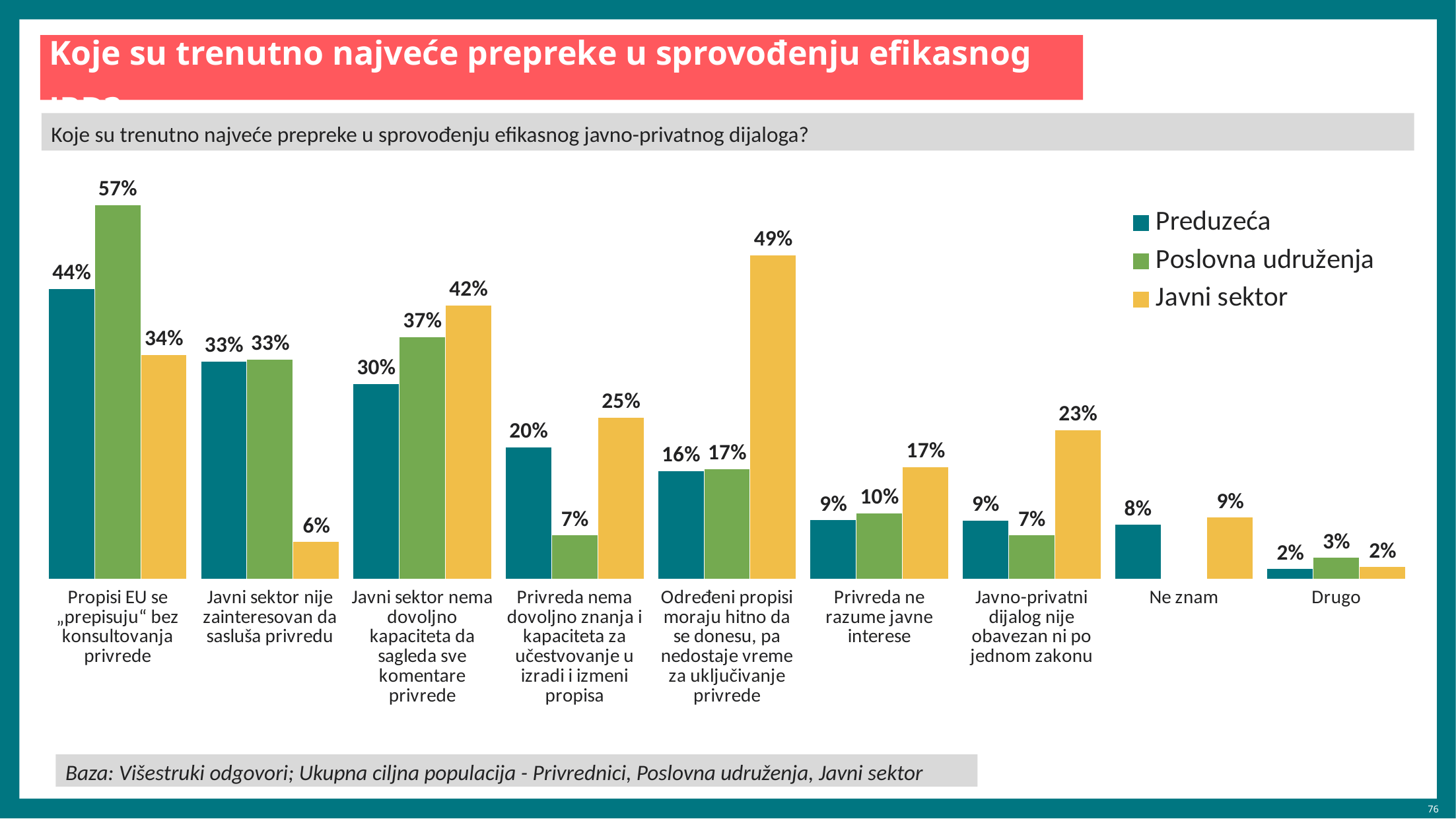
Which category has the highest value for Poslovna udruženja? Propisi EU se „prepisuju“ bez konsultovanja privrede In the category "Privreda nema dovoljno znanja i kapaciteta za učestvovanje u izradi i izmeni propisa", which series has the larger value: Preduzeća or Poslovna udruženja? Preduzeća Which category has the lowest value for Javni sektor? Drugo What is the value for Poslovna udruženja in the category "Javni sektor nema dovoljno kapaciteta da sagleda sve komentare privrede"? 37% What is the value for Preduzeća in the category "Propisi EU se „prepisuju“ bez konsultovanja privrede"? 44% What kind of chart is shown on the slide? Bar chart What is the value for Javni sektor in the category "Određeni propisi moraju hitno da se donesu, pa nedostaje vreme za uključivanje privrede"? 49% What is the difference between the Javni sektor and Preduzeća values in the category "Javno-privatni dijalog nije obavezan ni po jednom zakonu"? 14% Which series is shown in yellow in the legend? Javni sektor How many series does the legend list? 3 What is the value for Javni sektor in the category "Javni sektor nije zainteresovan da sasluša privredu"? 6% How many categories are shown on the x axis of the chart? 9